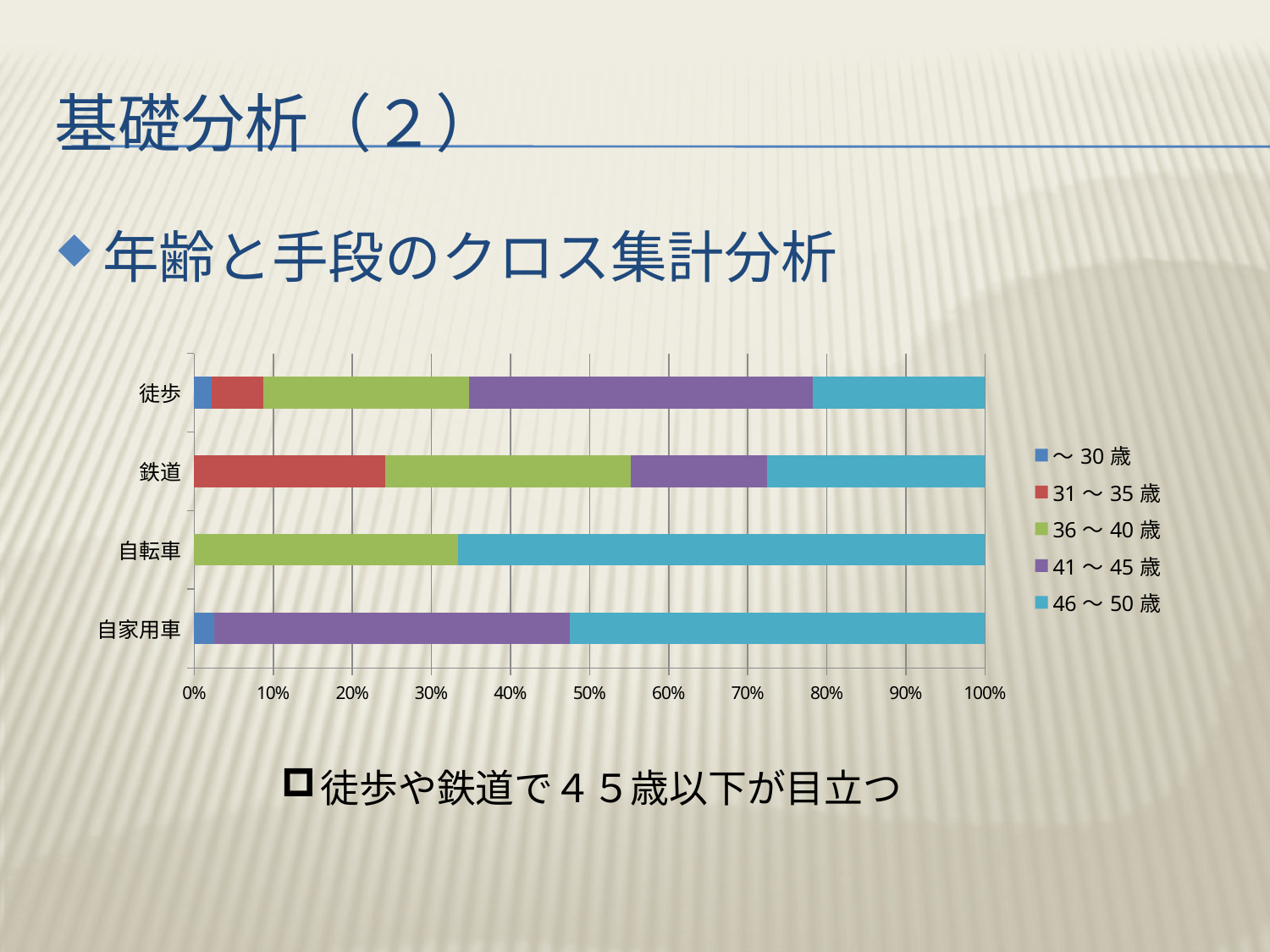
Is the 46～50歳 share for 自転車 greater or less than 60%? greater How many series does the chart legend list? 5 What kind of chart is shown on the slide? Stacked bar chart Which age group does the light blue colour represent in the chart legend? 46～50歳 Is the 41～45歳 share for 自家用車 greater or less than 40%? greater How many categories (transport modes) are shown on the vertical axis of the chart? 4 What is the total of the stacked bar for 徒歩? 100% Which has the larger 46～50歳 share, 自転車 or 徒歩? 自転車 Which has the larger 31～35歳 share, 鉄道 or 徒歩? 鉄道 Is the 46～50歳 share for 徒歩 greater or less than 30%? less Which transport mode has the largest 46～50歳 share? 自転車